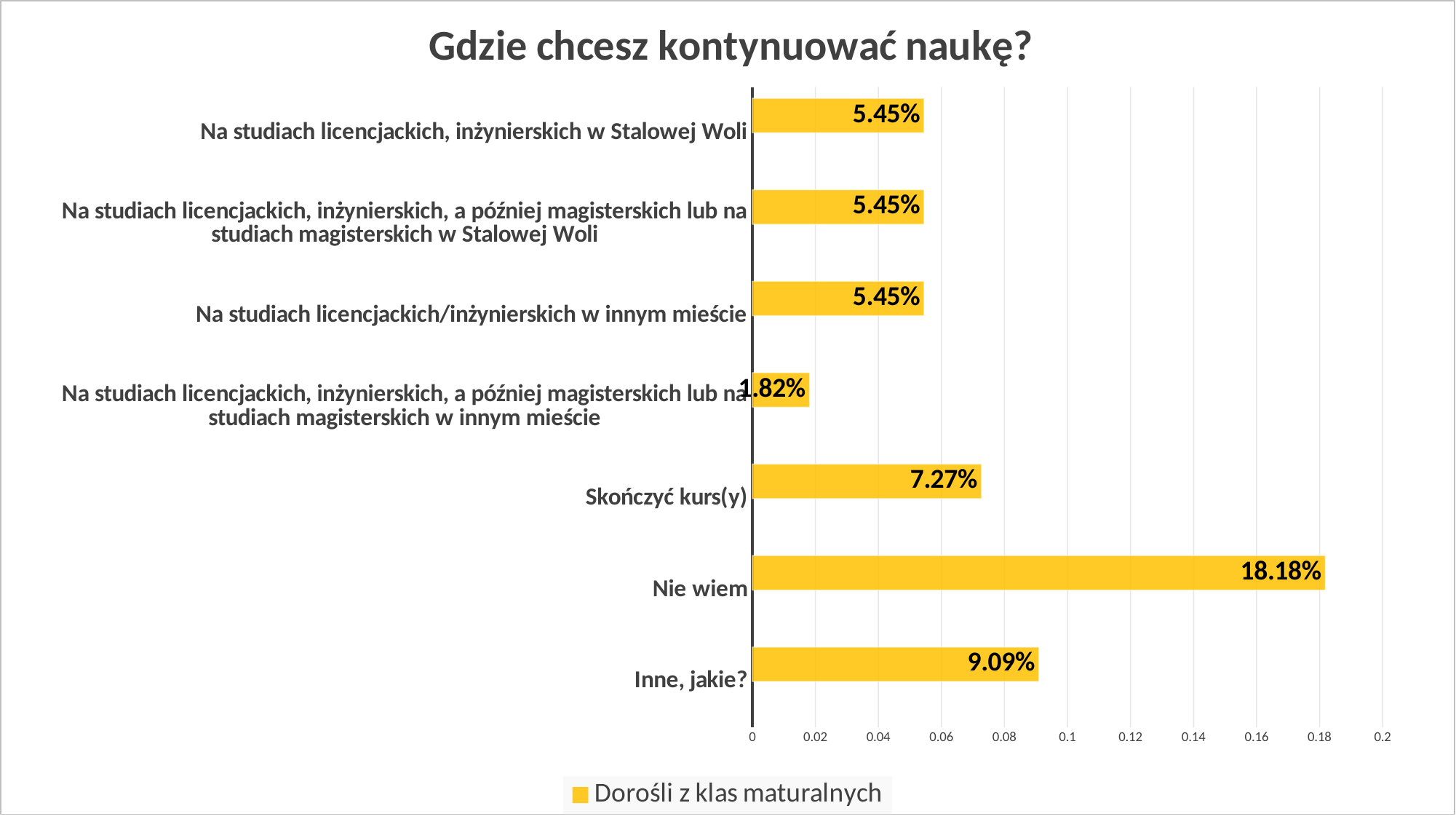
What is the value for "Inne, jakie?"? 9.09% What is the value for "Skończyć kurs(y)"? 7.27% Which category has the lowest value? Na studiach licencjackich, inżynierskich, a później magisterskich lub na studiach magisterskich w innym mieście What is the title of the chart? Gdzie chcesz kontynuować naukę? Which category has the highest value? Nie wiem What is the difference between the values for "Nie wiem" and "Inne, jakie?"? 9.09% What kind of chart is shown on the slide? Bar chart How many series does the legend list? 1 What is the value for "Na studiach licencjackich/inżynierskich w innym mieście"? 5.45% What is the value for "Nie wiem"? 18.18% How many categories are shown in the chart? 7 Which is larger: the value for "Skończyć kurs(y)" or the value for "Inne, jakie?"? Inne, jakie?